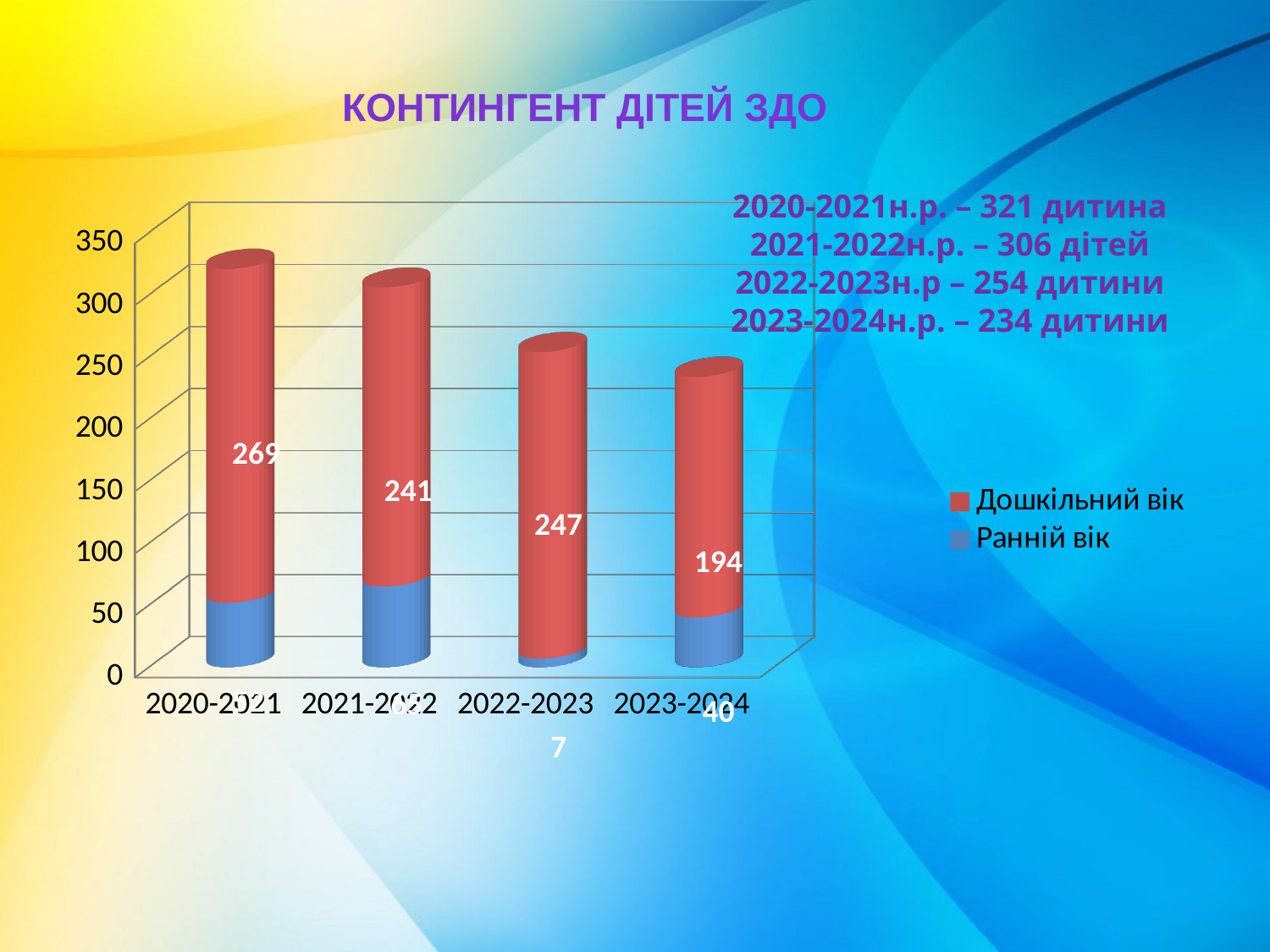
What is the difference between the Дошкільний вік values for 2020-2021 and 2023-2024? 75 What is the value for Дошкільний вік in 2020-2021? 269 What is the total number of children for 2020-2021 according to the slide? 321 дитина What is the value for Дошкільний вік in 2023-2024? 194 Do the total numbers of children rise or fall from 2020-2021 to 2023-2024? fall Which year has the highest value for Дошкільний вік? 2020-2021 Which year has the lowest value for Дошкільний вік? 2023-2024 What is the value for Ранній вік in 2022-2023? 7 Which is larger, the Дошкільний вік value for 2021-2022 or for 2022-2023? 2022-2023 What kind of chart is shown on the slide? bar chart How many academic years are shown on the x axis? 4 How many series does the legend list? 2